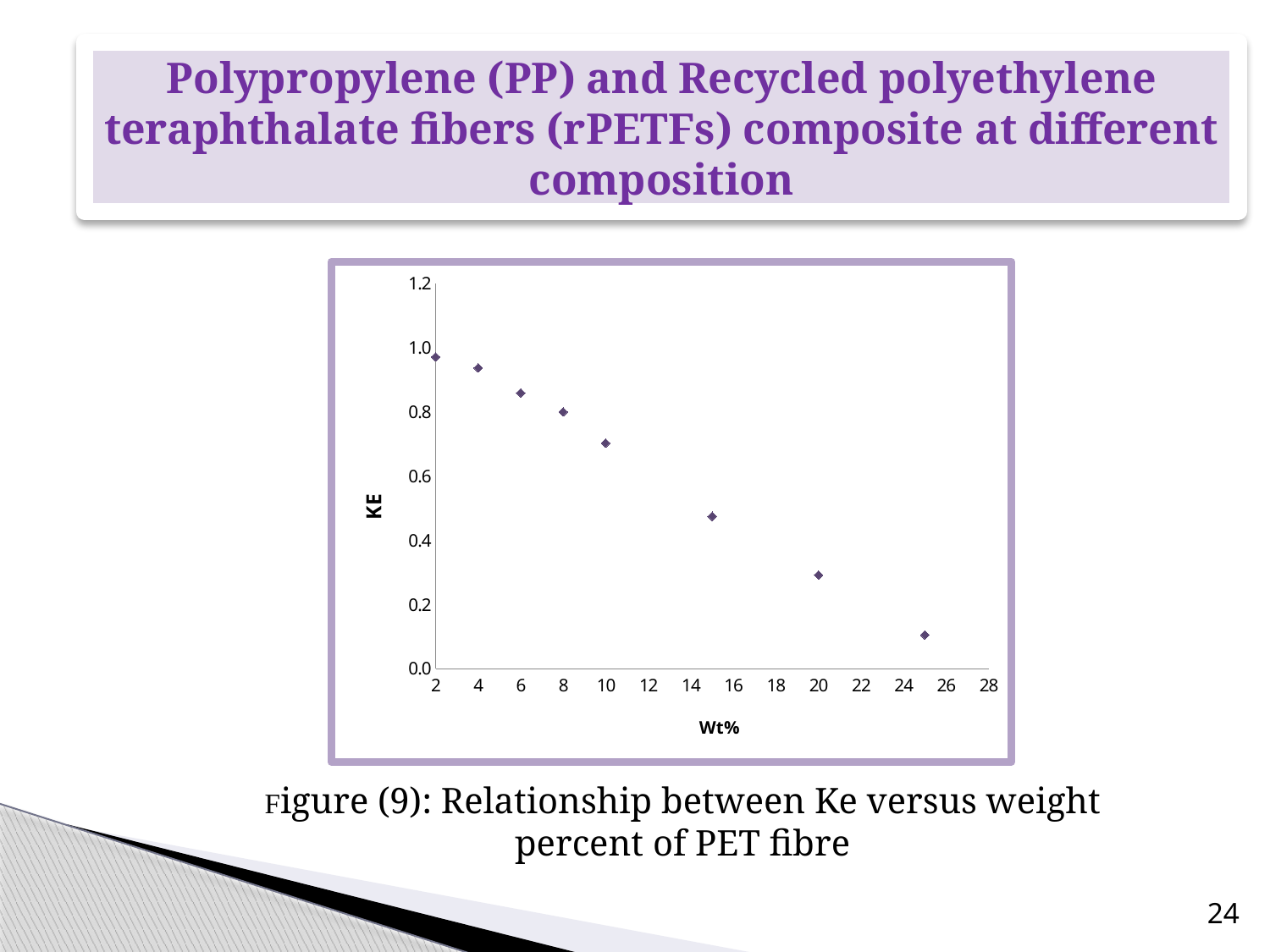
How many data points are plotted on the chart? 8 Do the KE values rise or fall as Wt% increases along the x axis? fall What kind of chart is shown on the slide? scatter chart Is the KE value at 20 Wt% greater or less than 0.4? less Which has a larger KE value: the point at 6 Wt% or the point at 20 Wt%? 6 Wt% Is the KE value at 25 Wt% greater or less than 0.2? less Is the KE value at 15 Wt% greater or less than 0.6? less At which Wt% value is KE highest? 2 At which Wt% value is KE lowest? 25 What is the label on the y axis of the chart? KE